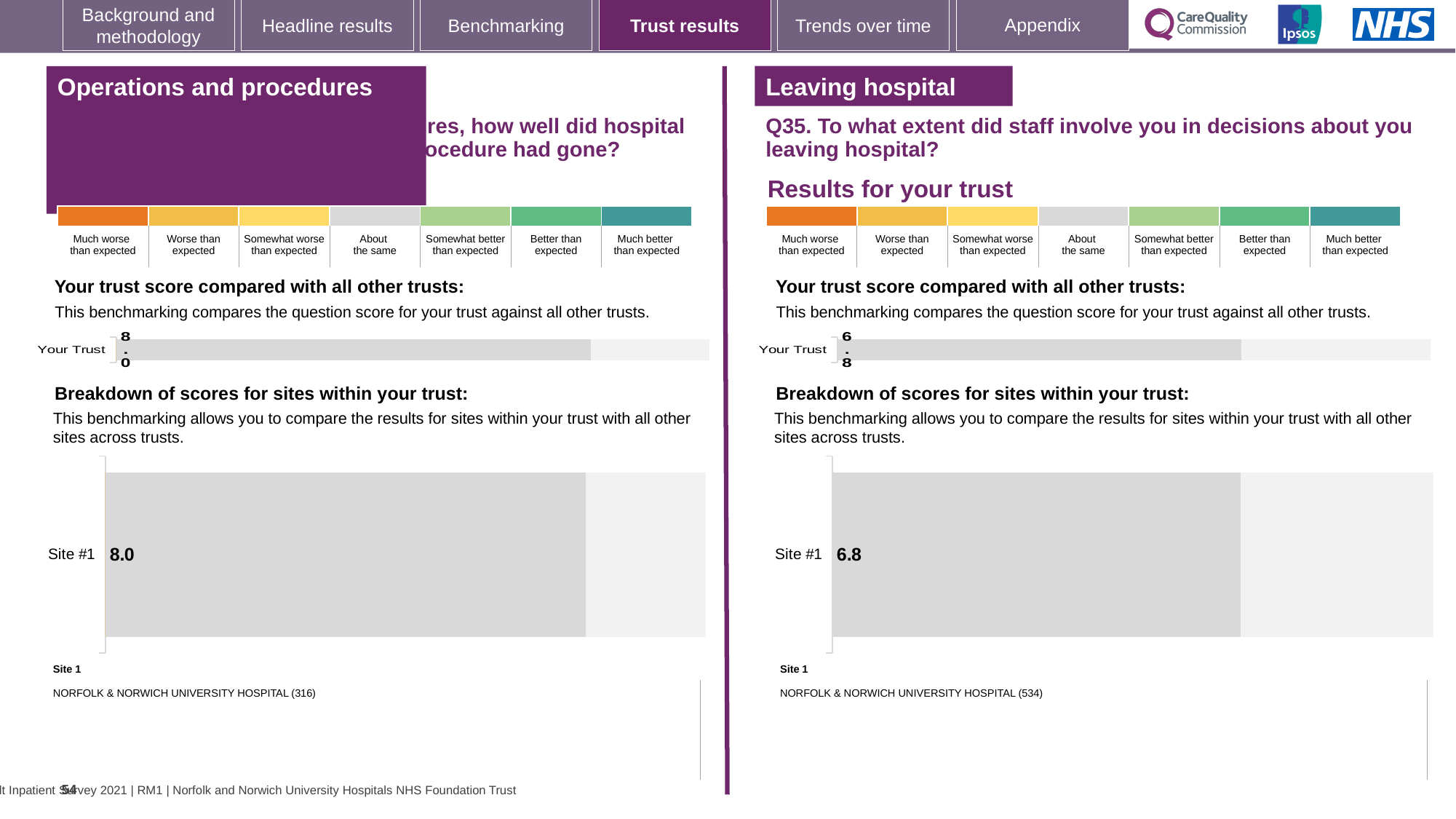
What is the difference between the Your Trust score for Operations and procedures and the Your Trust score for Leaving hospital? 1.2 What is the difference between the Site #1 score in the Operations and procedures section and the Site #1 score in the Leaving hospital section? 1.2 Which section shows the higher Site #1 score: Operations and procedures or Leaving hospital? Operations and procedures What type of chart is used to show the breakdown of scores for sites within your trust in the Leaving hospital section? Bar chart In the Leaving hospital section, what score is shown for Site #1 in the breakdown of scores for sites chart? 6.8 How many bars are plotted in the 'Your trust score compared with all other trusts' chart in the Leaving hospital section? 1 How many sites are shown in the breakdown of scores for sites chart in the Operations and procedures section? 1 In the Leaving hospital section, what is the score shown for Your Trust in the 'Your trust score compared with all other trusts' chart? 6.8 In the Leaving hospital section, which hospital is listed as Site 1 below the breakdown chart? NORFOLK & NORWICH UNIVERSITY HOSPITAL In the Operations and procedures section, what score is shown for Site #1 in the breakdown of scores for sites chart? 8.0 What is the category label of the single bar in the 'Your trust score compared with all other trusts' chart in the Operations and procedures section? Your Trust In the Operations and procedures section, what is the score shown for Your Trust in the 'Your trust score compared with all other trusts' chart? 8.0